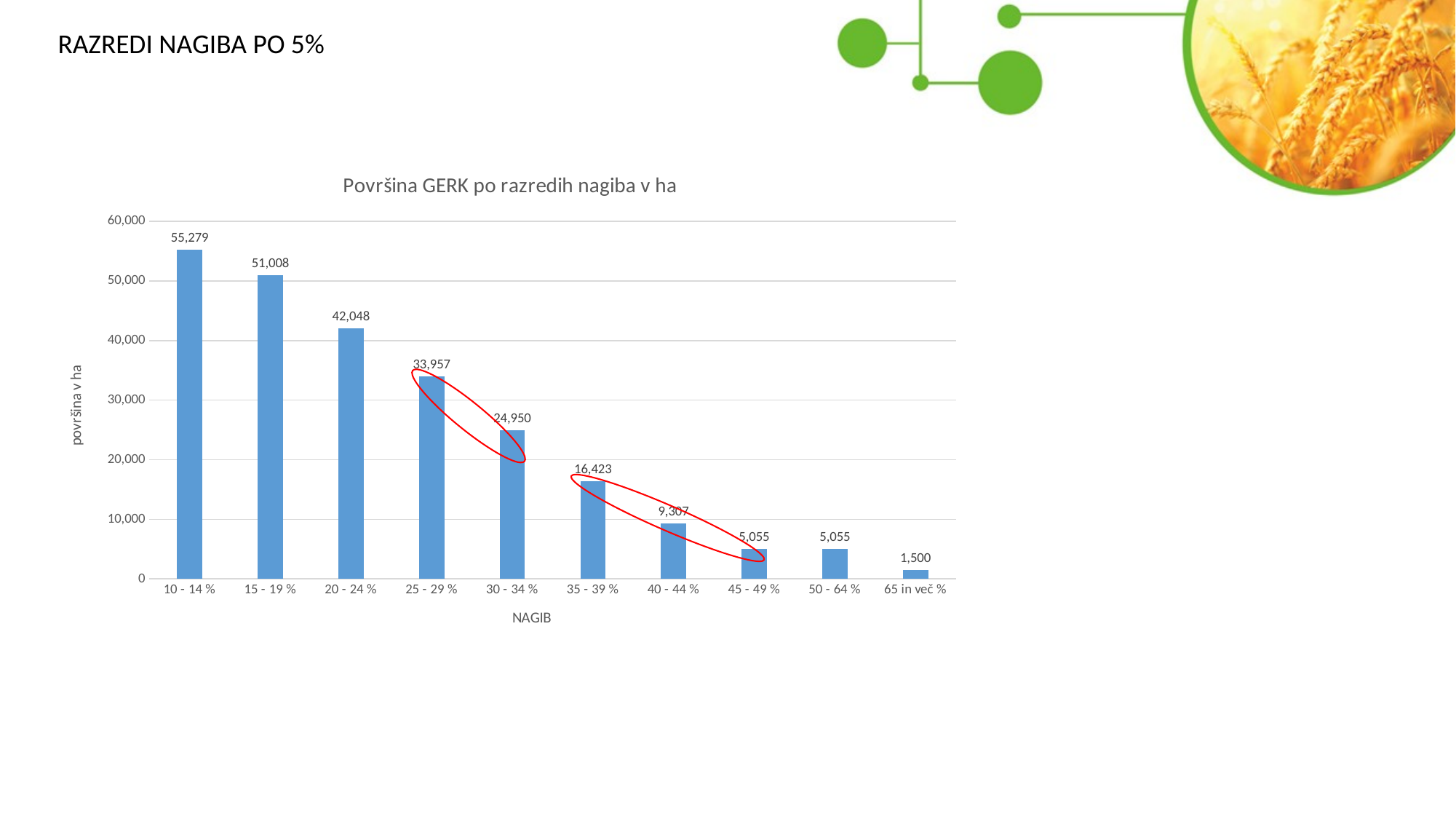
What is the difference between the values for 10 - 14 % and 15 - 19 %? 4,271 What is the value for the 25 - 29 % slope class? 33,957 Do the values rise or fall from left to right along the x axis? fall Which slope class has the lowest value? 65 in več % Which slope class has the highest value? 10 - 14 % What kind of chart is shown on the slide? bar chart What is the difference between the values for 25 - 29 % and 30 - 34 %? 9,007 What is the value for the 65 in več % slope class? 1,500 Which is larger, the value for 20 - 24 % or the value for 35 - 39 %? 20 - 24 % What is the value for the 40 - 44 % slope class? 9,307 How many slope classes are shown on the x axis? 10 What is the value for the 10 - 14 % slope class? 55,279